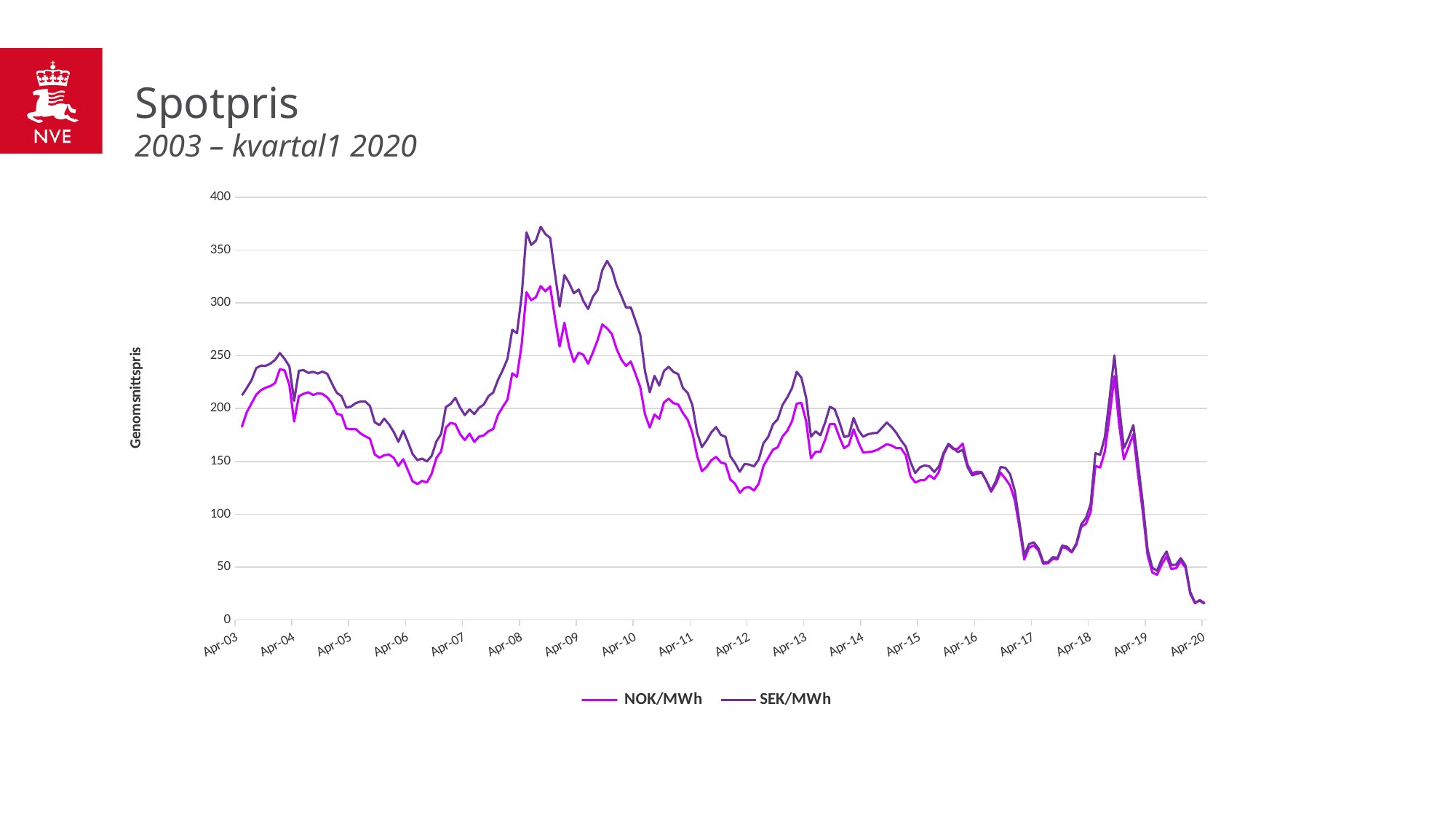
At Apr-09, which series has the higher value, NOK/MWh or SEK/MWh? SEK/MWh How many series does the legend list? 2 What kind of chart is shown on the slide? line chart Is the highest point of the NOK/MWh series greater or less than 300? greater Is the SEK/MWh value at Apr-17 greater or less than 100? less Between Apr-19 and Apr-20, do the values rise or fall? fall Is the highest point of the SEK/MWh series greater or less than 350? greater What is the label on the vertical axis? Genomsnittspris Which series is higher for most of the period shown, NOK/MWh or SEK/MWh? SEK/MWh What are the two series named in the legend? NOK/MWh and SEK/MWh